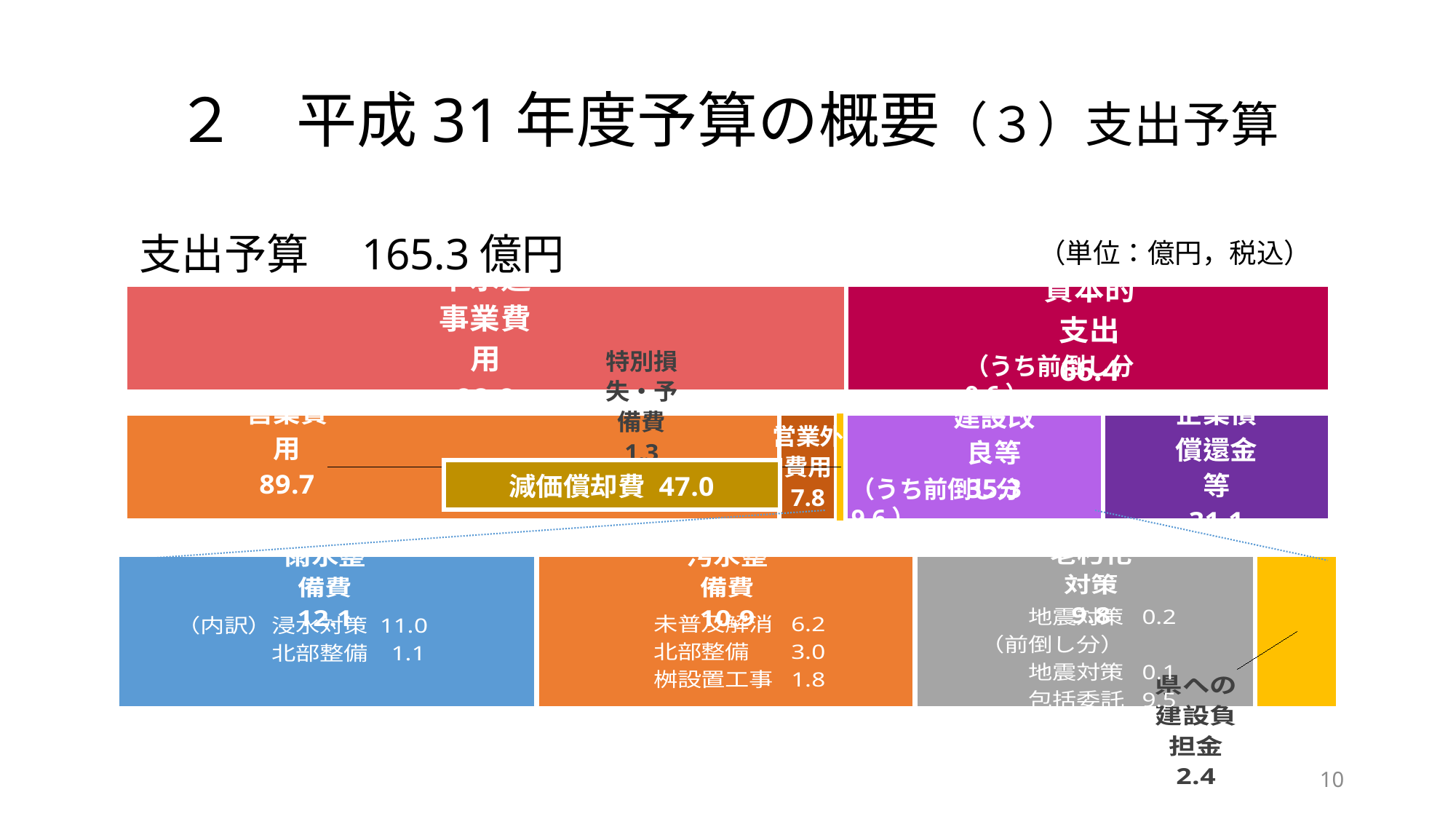
Which is larger, 営業費用 or 営業外費用? 営業費用 What kind of chart is shown on the slide? bar chart Within 雨水整備費, what is the difference between 浸水対策 and 北部整備? 9.9 What is the value shown for 営業費用? 89.7 Within 老朽化対策, what is the value for 包括委託? 9.5 Within 雨水整備費, what is the value for 浸水対策? 11.0 What is the value shown for 営業外費用? 7.8 What is the value shown for 資本的支出? 66.4 Within 汚水整備費, what is the value for 未普及解消? 6.2 What is the value shown for 減価償却費? 47.0 What total 支出予算 amount is stated above the chart? 165.3 億円 What is the value shown for 県への建設負担金? 2.4